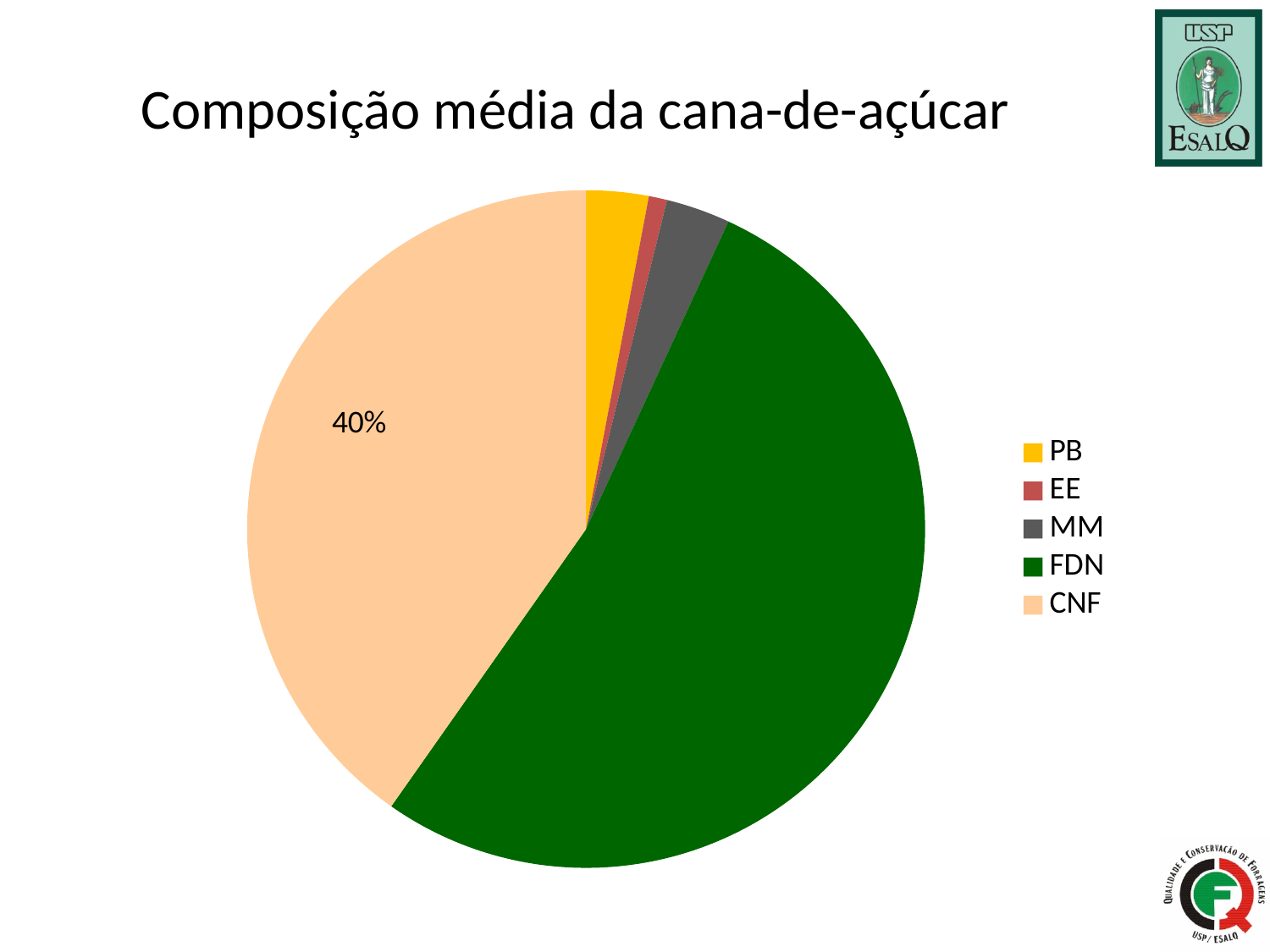
What kind of chart is shown on the slide? pie chart Which category has the smallest slice of the pie? EE Which slice is larger, CNF or MM? CNF What is the title of the chart? Composição média da cana-de-açúcar How many slices does the pie chart have? 5 What colour is the FDN slice in the pie chart? dark green How many entries does the legend list? 5 Which category has the largest slice of the pie? FDN What share of the pie does CNF represent? 40% Which slice is larger, FDN or CNF? FDN Which slice is larger, PB or EE? PB